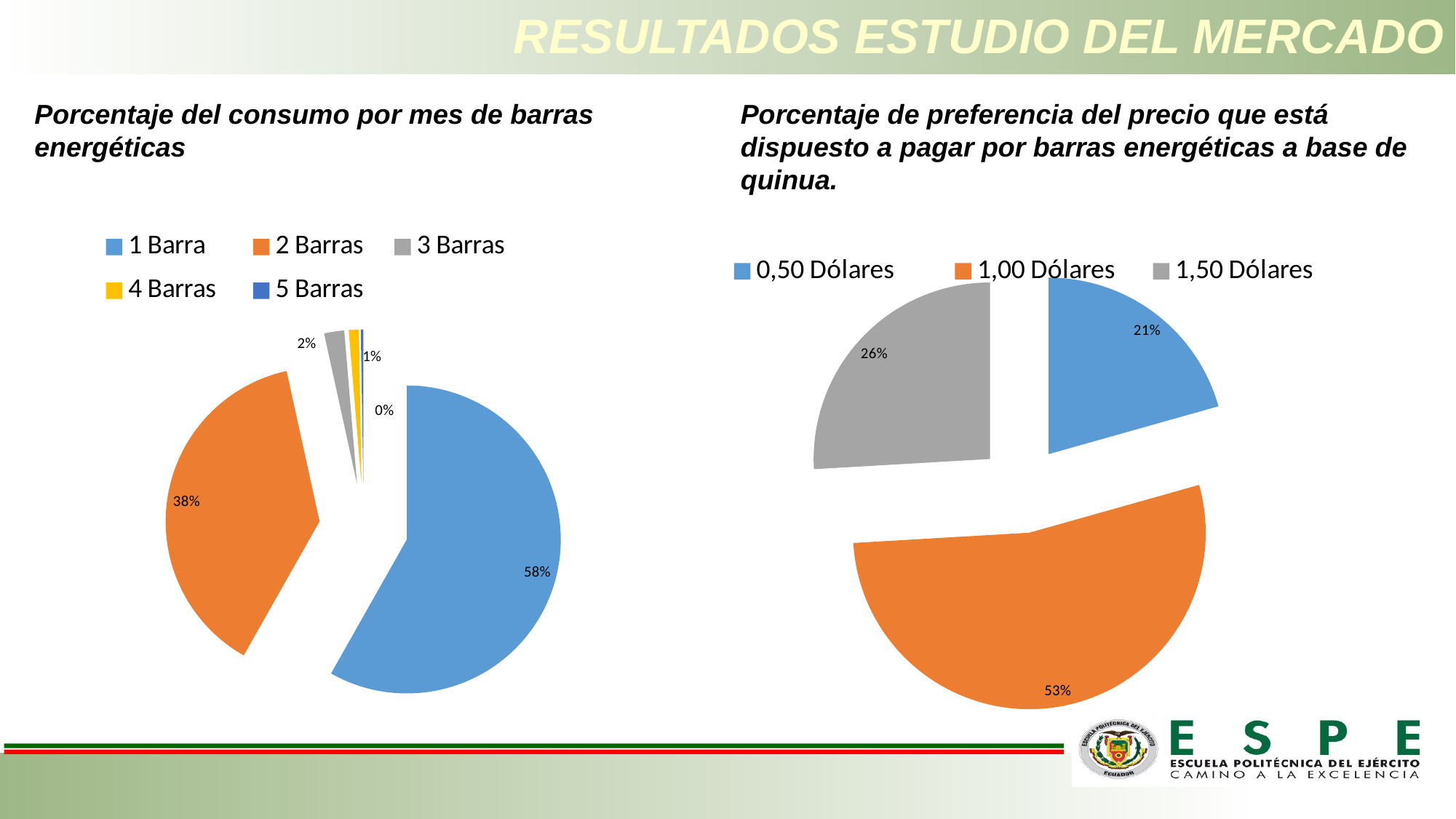
In the right chart (Porcentaje de preferencia del precio), which is larger, the share for 1,50 Dólares or for 0,50 Dólares? 1,50 Dólares In the left chart (Porcentaje del consumo por mes de barras energéticas), what percentage is shown for 3 Barras? 2% In the left chart (Porcentaje del consumo por mes de barras energéticas), what percentage is shown for 2 Barras? 38% In the left chart (Porcentaje del consumo por mes de barras energéticas), how many categories does the legend list? 5 In the right chart (Porcentaje de preferencia del precio), what percentage is shown for 0,50 Dólares? 21% In the left chart (Porcentaje del consumo por mes de barras energéticas), what percentage is shown for 1 Barra? 58% In the left chart (Porcentaje del consumo por mes de barras energéticas), which category has the largest share? 1 Barra In the right chart (Porcentaje de preferencia del precio), what percentage is shown for 1,50 Dólares? 26% In the left chart (Porcentaje del consumo por mes de barras energéticas), what is the difference between the shares for 1 Barra and 2 Barras? 20% What kind of chart is the left chart (Porcentaje del consumo por mes de barras energéticas)? Pie chart In the right chart (Porcentaje de preferencia del precio), what percentage is shown for 1,00 Dólares? 53% In the right chart (Porcentaje de preferencia del precio), which price option has the smallest share? 0,50 Dólares